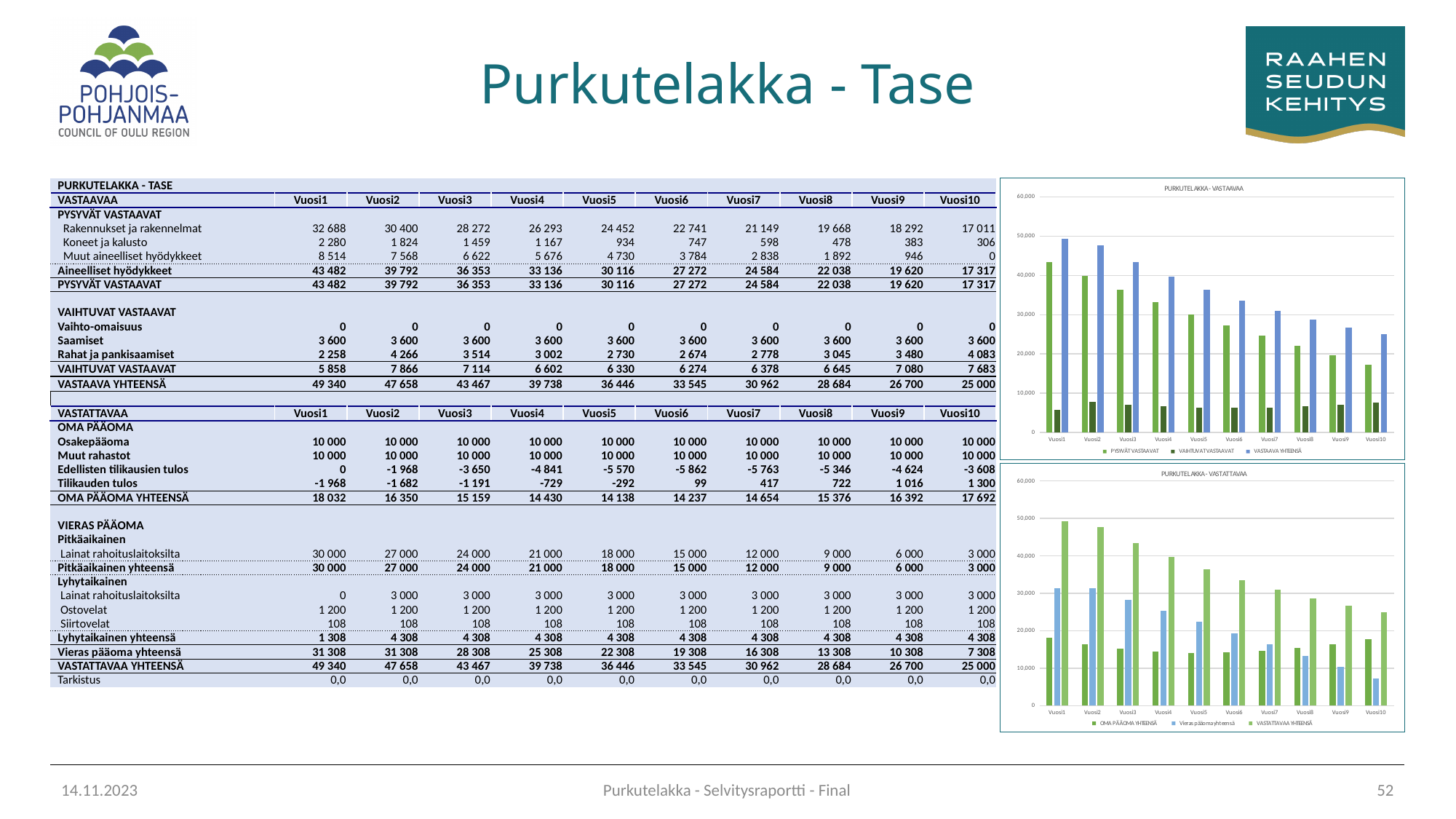
In the PURKUTELAKKA - VASTAAVAA chart, is the VASTAAVA YHTEENSÄ value for Vuosi1 greater or less than 40,000? greater In the PURKUTELAKKA - VASTATTAVAA chart, is the Vieras pääoma yhteensä value for Vuosi10 greater or less than 10,000? less In the PURKUTELAKKA - VASTAAVAA chart, which year has the highest VASTAAVA YHTEENSÄ bar? Vuosi1 How many year categories are shown on the x axis of the PURKUTELAKKA - VASTAAVAA chart? 10 In the PURKUTELAKKA - VASTATTAVAA chart, do the Vieras pääoma yhteensä values rise or fall from Vuosi1 to Vuosi10? Fall How many series does the legend of the PURKUTELAKKA - VASTATTAVAA chart list? 3 In the PURKUTELAKKA - VASTATTAVAA chart, which is larger for Vuosi1: OMA PÄÄOMA YHTEENSÄ or Vieras pääoma yhteensä? Vieras pääoma yhteensä How many series does the legend of the PURKUTELAKKA - VASTAAVAA chart list? 3 In the PURKUTELAKKA - VASTAAVAA chart, do the VASTAAVA YHTEENSÄ values rise or fall from Vuosi1 to Vuosi10? Fall In the PURKUTELAKKA - VASTAAVAA chart, which year has the lowest VASTAAVA YHTEENSÄ bar? Vuosi10 What kind of chart is the PURKUTELAKKA - VASTAAVAA chart? Bar chart In the PURKUTELAKKA - VASTAAVAA chart, is the PYSYVÄT VASTAAVAT value for Vuosi10 greater or less than 20,000? less